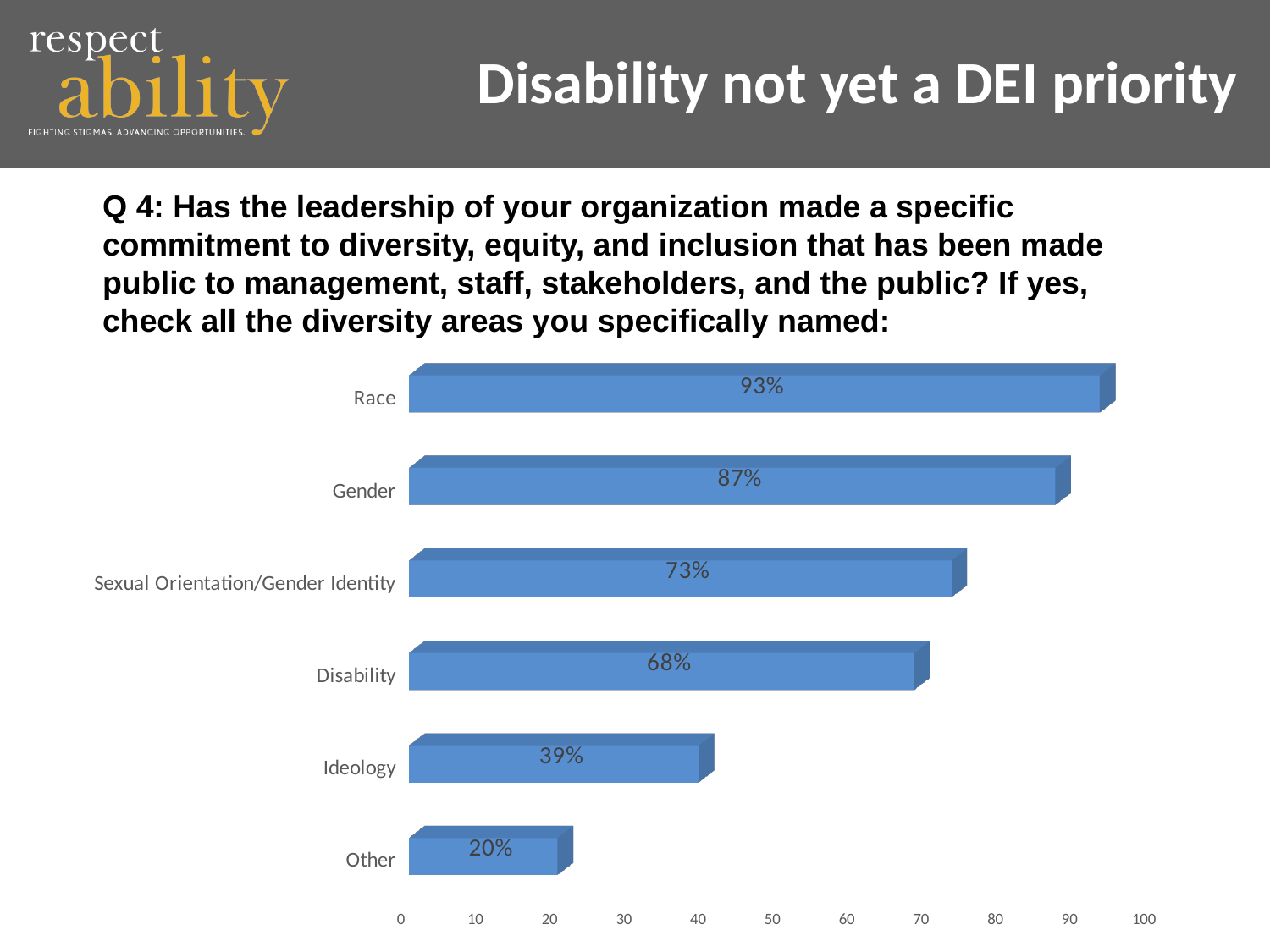
What kind of chart is shown on the slide? Bar chart What percentage is shown for Disability? 68% What is the difference in percentage points between Race and Disability? 25 Which diversity area has the lowest percentage? Other What percentage is shown for Sexual Orientation/Gender Identity? 73% What is the maximum value shown on the horizontal axis? 100 Which is larger, the value for Gender or the value for Disability? Gender Which diversity area has the highest percentage? Race How many diversity areas are shown in the chart? 6 What percentage is shown for Ideology? 39% What percentage is shown for Race? 93% What is the difference in percentage points between Gender and Ideology? 48